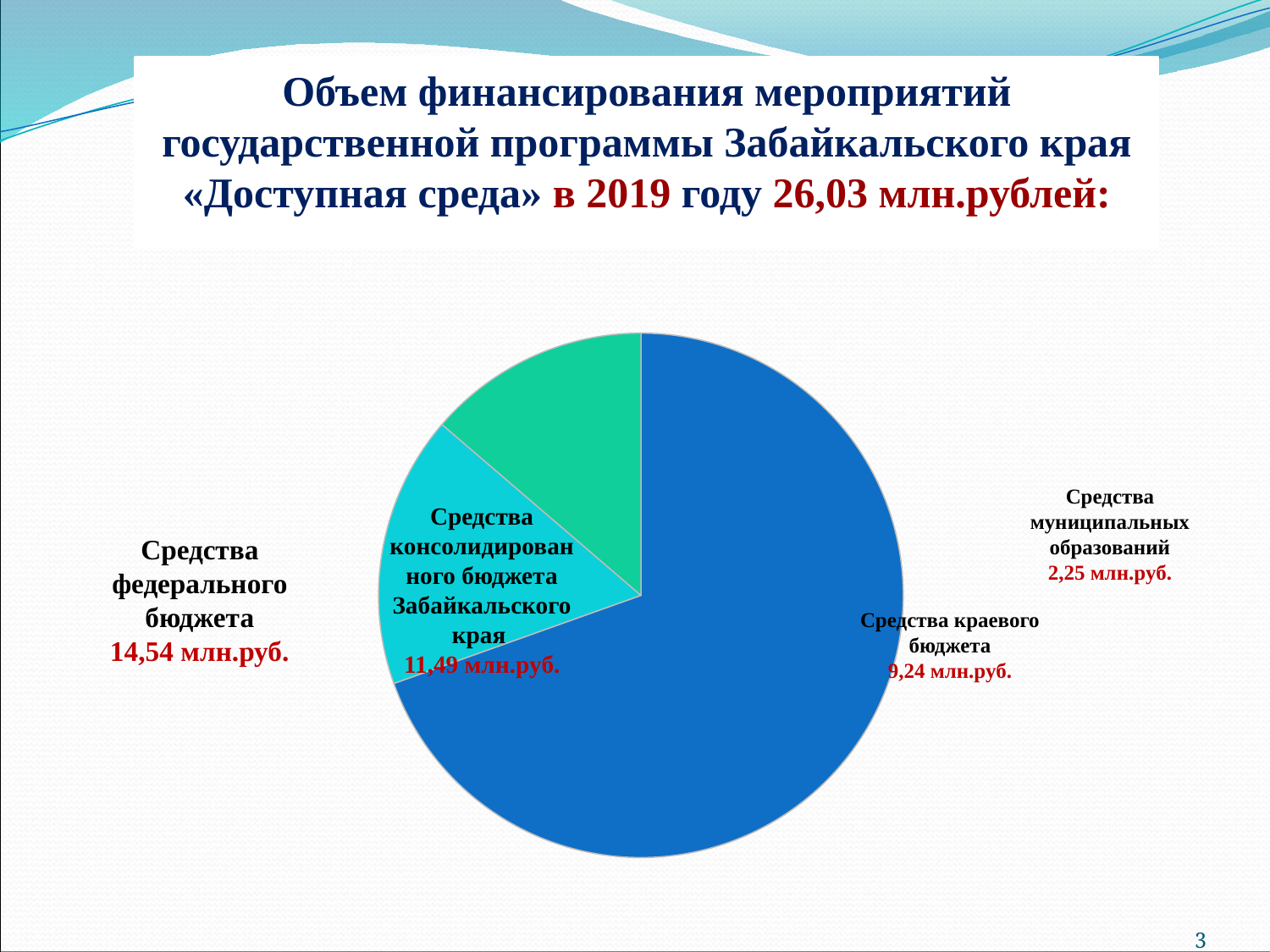
What amount is given for Средства консолидированного бюджета Забайкальского края? 11,49 млн.руб. Which funding source has the largest amount shown on the slide? Средства федерального бюджета Which is larger: Средства краевого бюджета or Средства муниципальных образований? Средства краевого бюджета What is the difference between Средства федерального бюджета and Средства консолидированного бюджета Забайкальского края? 3,05 млн.руб. What amount is given for Средства федерального бюджета? 14,54 млн.руб. What amount is given for Средства муниципальных образований? 2,25 млн.руб. What is the difference between Средства краевого бюджета and Средства муниципальных образований? 6,99 млн.руб. How many slices does the pie chart have? 3 Which funding source has the smallest amount shown on the slide? Средства муниципальных образований What amount is given for Средства краевого бюджета? 9,24 млн.руб. What kind of chart is shown on the slide? pie chart What total funding amount for 2019 is stated in the slide title? 26,03 млн.рублей